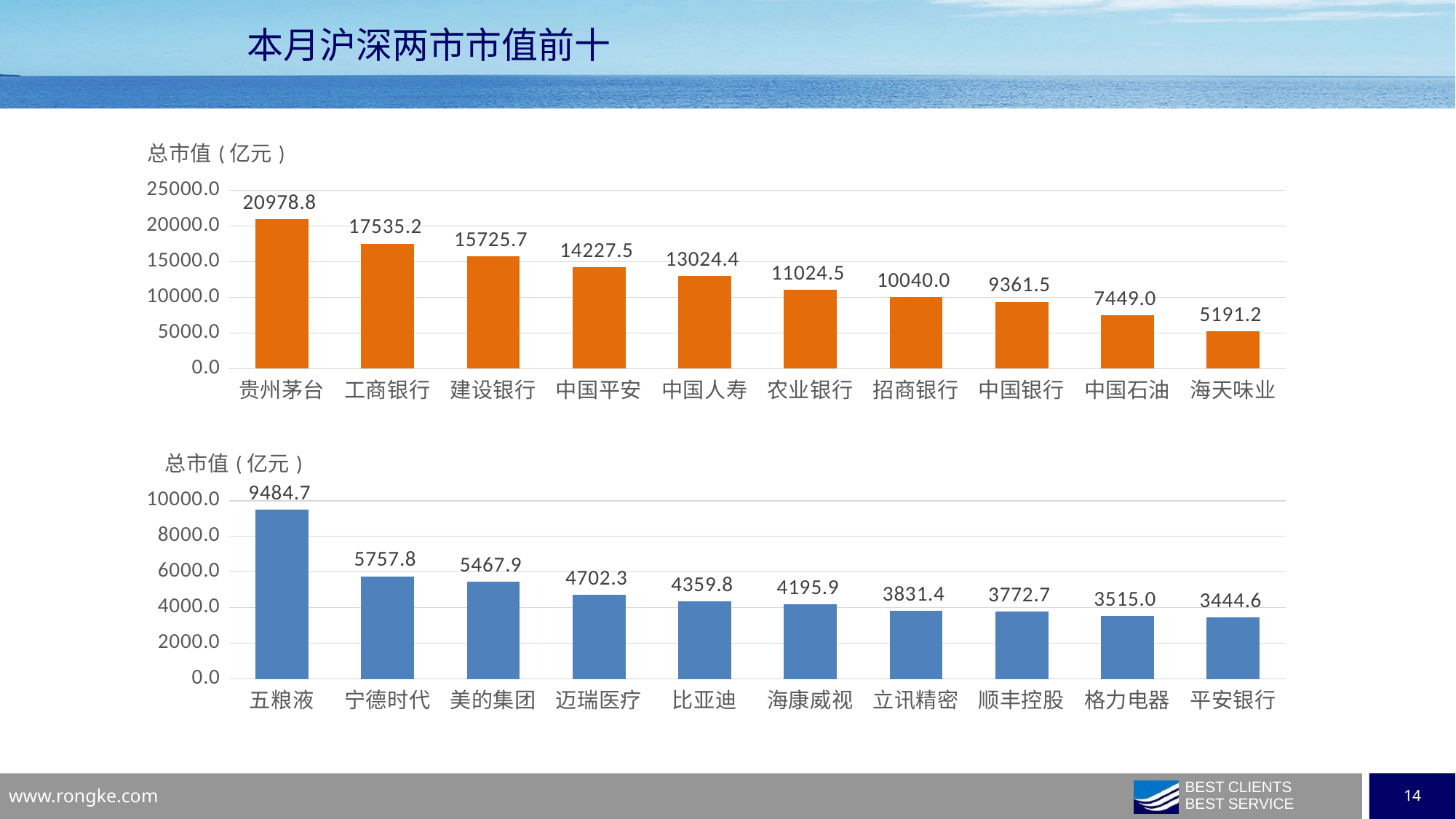
In the top chart, which is larger, 中国人寿 or 农业银行? 中国人寿 In the bottom chart, do the values rise or fall from left to right? fall How many categories are shown in the bottom chart? 10 In the bottom chart, what is the value for 宁德时代? 5757.8 In the bottom chart, which category has the highest value? 五粮液 In the top chart, what is the value for 中国平安? 14227.5 What kind of chart is the top chart? bar chart In the bottom chart, what is the difference between 五粮液 and 宁德时代? 3726.9 In the top chart, what is the difference between 贵州茅台 and 工商银行? 3443.6 In the bottom chart, what is the value for 格力电器? 3515.0 In the top chart, which category has the lowest value? 海天味业 In the top chart, what is the value for 贵州茅台? 20978.8